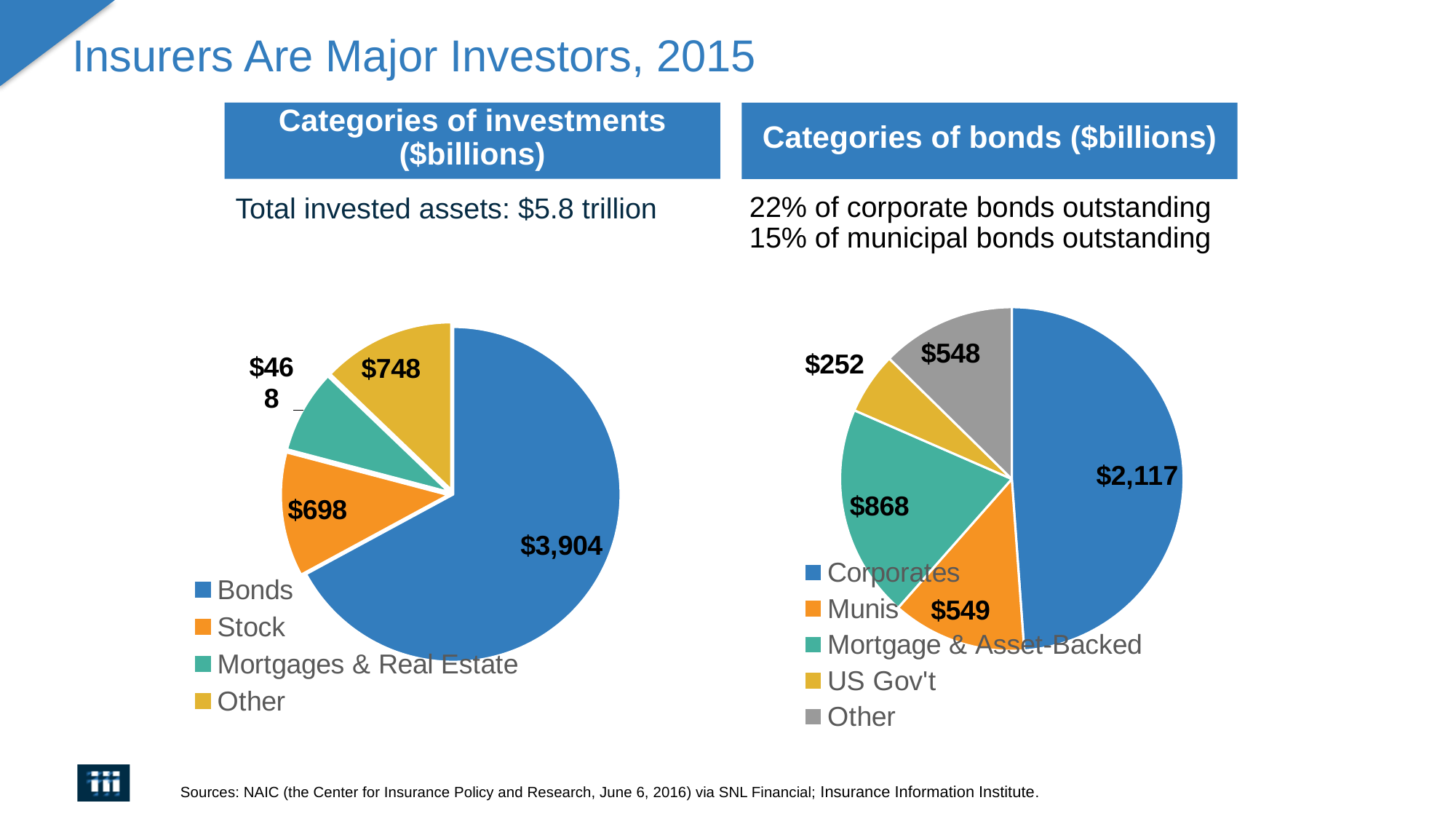
In the Categories of bonds chart, what is the value for Corporates? $2,117 In the Categories of investments chart, how many categories does the legend list? 4 In the Categories of investments chart, what is the value for Other? $748 In the Categories of investments chart, what is the difference between Other and Stock? $50 In the Categories of bonds chart, what is the value for Mortgage & Asset-Backed? $868 What type of chart is used for the Categories of bonds? Pie chart In the Categories of investments chart, which category has the smallest slice? Mortgages & Real Estate In the Categories of bonds chart, which is larger, Mortgage & Asset-Backed or Munis? Mortgage & Asset-Backed In the Categories of investments chart, what is the value for Stock? $698 In the Categories of bonds chart, which category has the largest slice? Corporates In the Categories of bonds chart, what is the value for US Gov't? $252 In the Categories of investments chart, what is the value for Bonds? $3,904